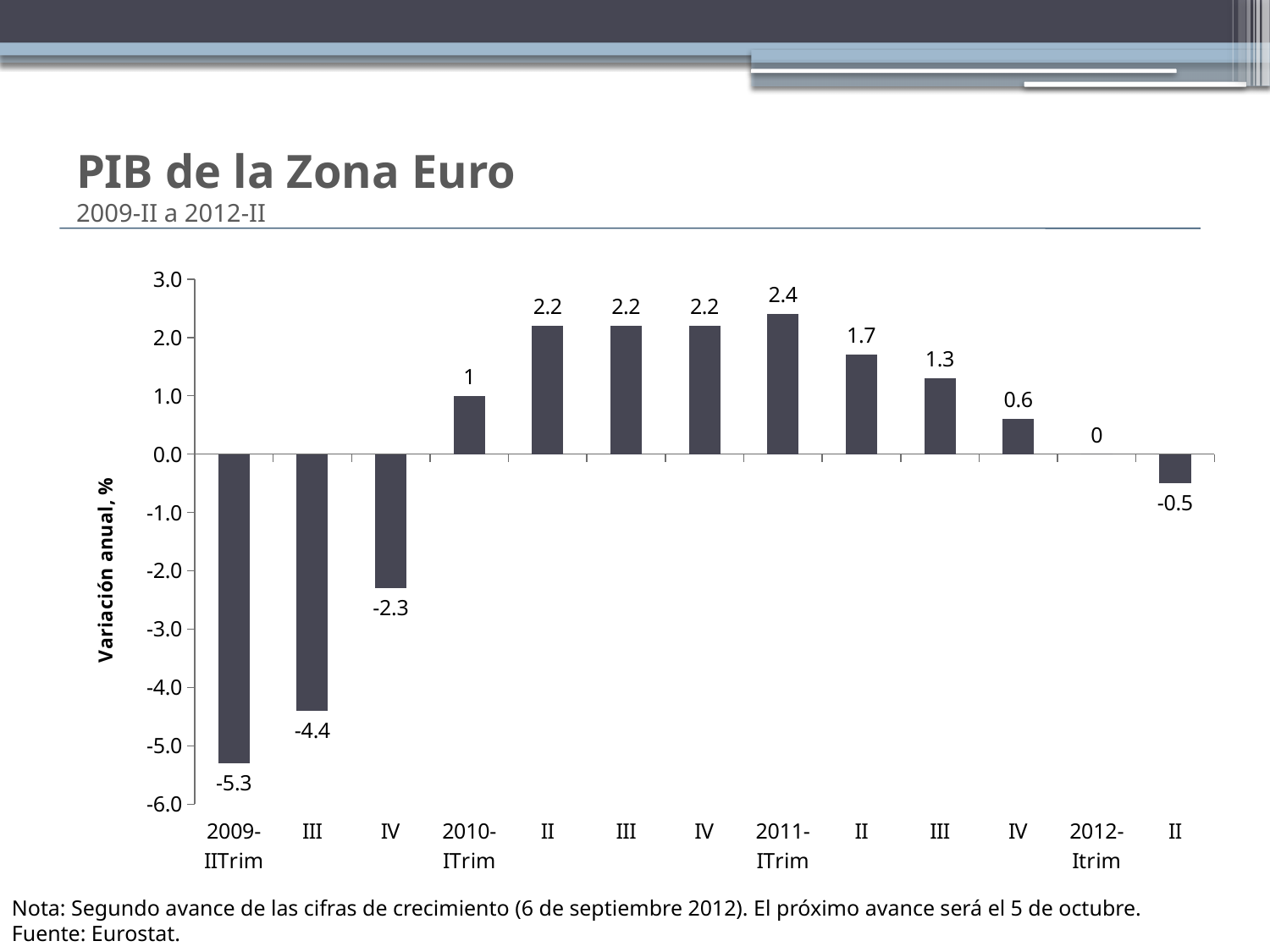
How many bars (categories) are shown on the chart? 13 Do the values rise or fall from 2011-ITrim to 2012 II? Fall Which is larger, the value for 2010-ITrim or the value for 2011 III? 2011 III What is the label of the vertical axis? Variación anual, % What is the value for 2009-IITrim? -5.3 What is the value for the last bar, 2012 II? -0.5 Which category has the lowest value? 2009-IITrim Which category has the highest value? 2011-ITrim What is the value for 2011-ITrim? 2.4 What is the value for 2012-Itrim? 0 What kind of chart is shown on the slide? Bar chart What is the difference between the value for 2011-ITrim and the value for 2011 II? 0.7